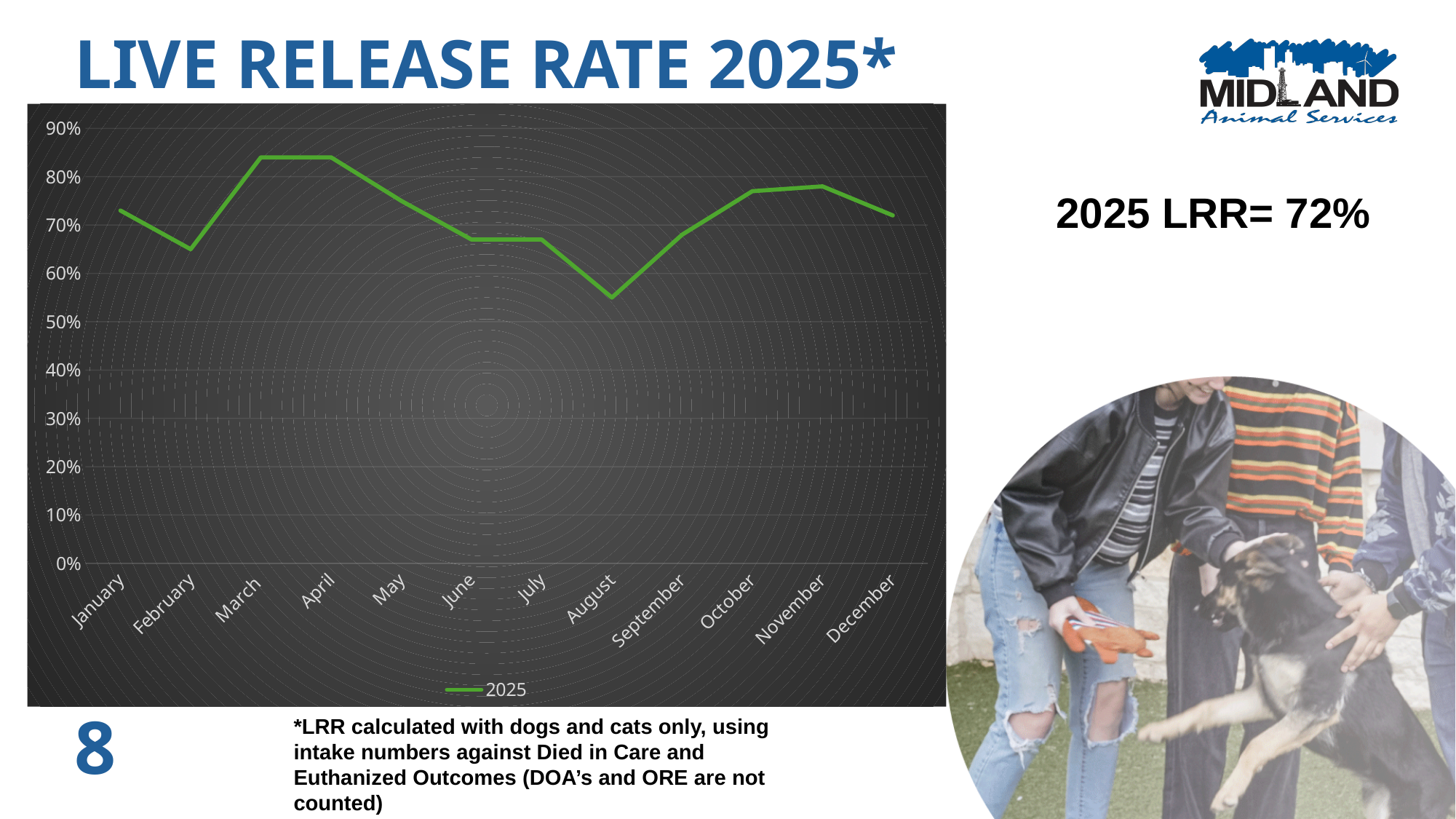
How many series does the chart's legend list? 1 What kind of chart is shown on the slide? line chart Which month has the lowest live release rate in the chart? August What is the name of the series shown in the chart's legend? 2025 Is the value for February greater or less than 70%? less Do the values rise or fall from April to August? fall Which month has the higher live release rate, February or March? March How many months are plotted along the x axis of the chart? 12 Which month has the higher live release rate, August or October? October Is the value for August greater or less than 60%? less Is the value for October greater or less than 70%? greater